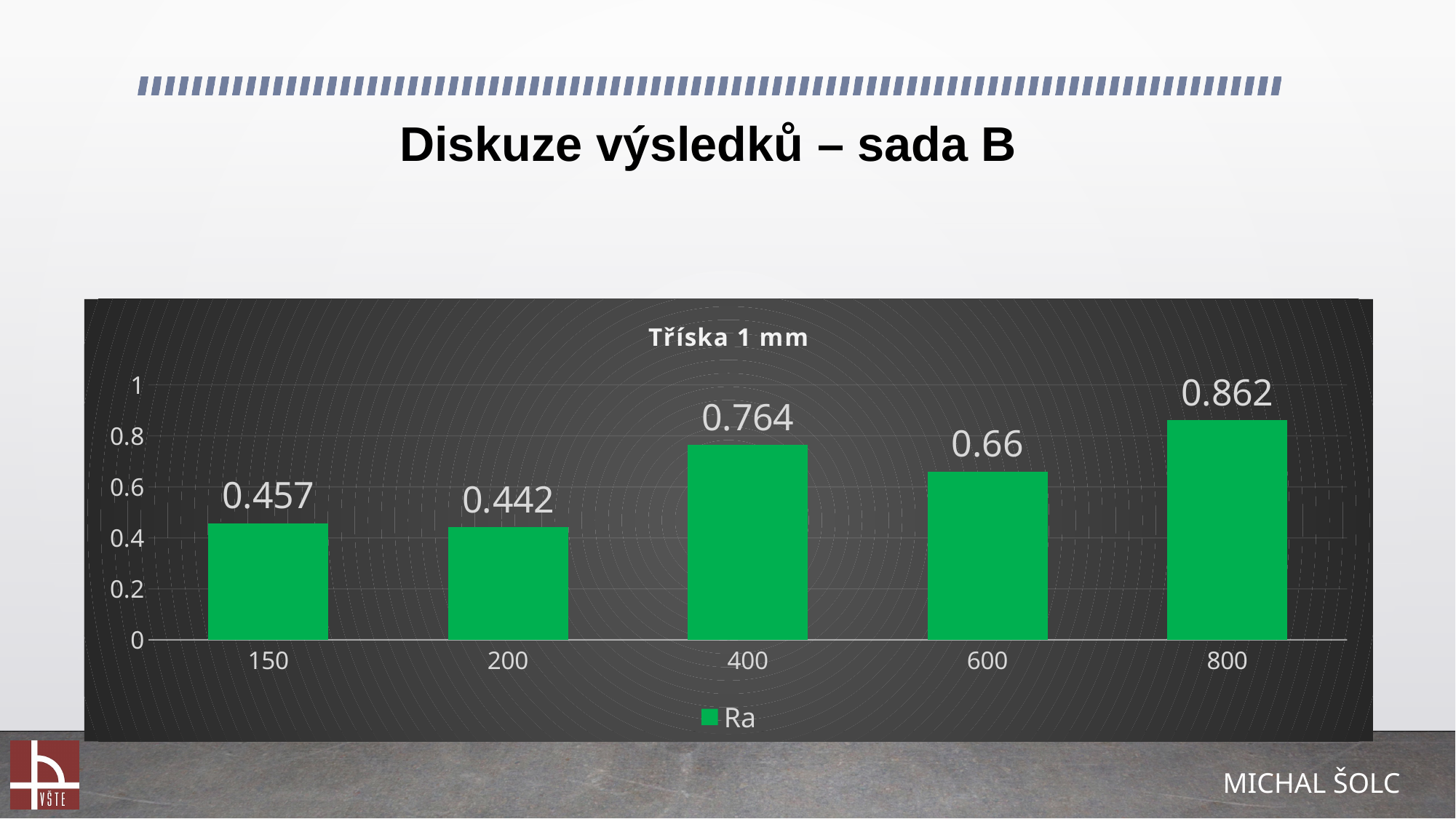
What is the title of the chart? Tříska 1 mm Is the Ra value for 600 greater or less than 0.8? less What type of chart is shown on the slide? bar chart How many categories are shown on the x axis? 5 What is the difference between the Ra values for 800 and 600? 0.202 What is the Ra value for category 800? 0.862 What is the Ra value for category 150? 0.457 Which category has the lowest Ra value? 200 What is the difference between the Ra values for 150 and 200? 0.015 Which has a larger Ra value, 400 or 600? 400 What is the Ra value for category 400? 0.764 Which category has the highest Ra value? 800